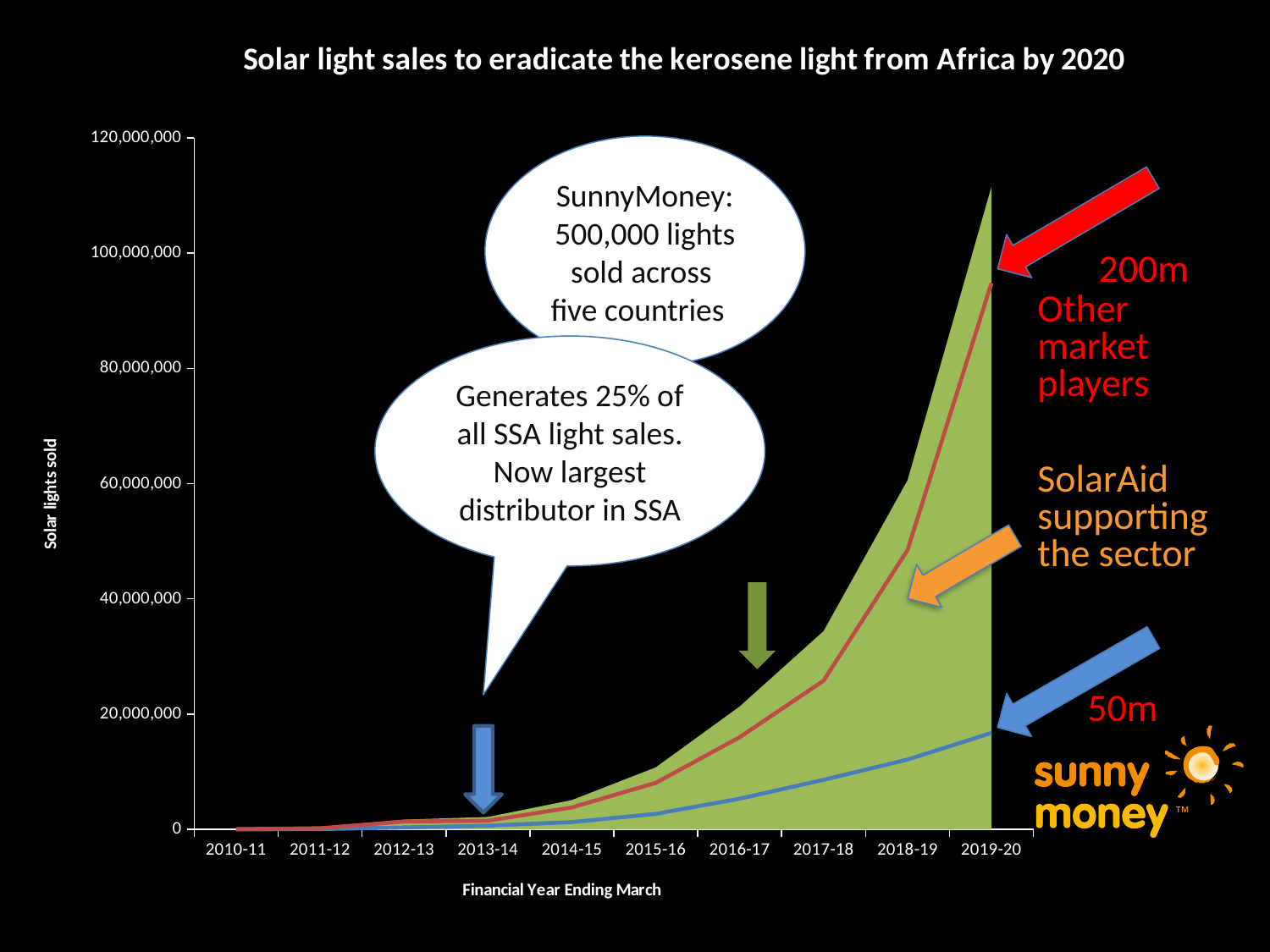
Is the value of the red line for 2019-20 greater or less than 100,000,000? less What is the title of the chart? Solar light sales to eradicate the kerosene light from Africa by 2020 Which financial year has the highest value for the green shaded area? 2019-20 Which financial year has the lowest value for the green shaded area? 2010-11 Do the values in the chart rise or fall from 2010-11 to 2019-20? rise Is the value of the blue line for 2019-20 greater or less than 20,000,000? less Is the value of the red line for 2017-18 greater or less than 20,000,000? greater At 2019-20, which is higher: the red line or the blue line? the red line How many financial years are shown on the x axis of the chart? 10 What is the label on the x axis of the chart? Financial Year Ending March